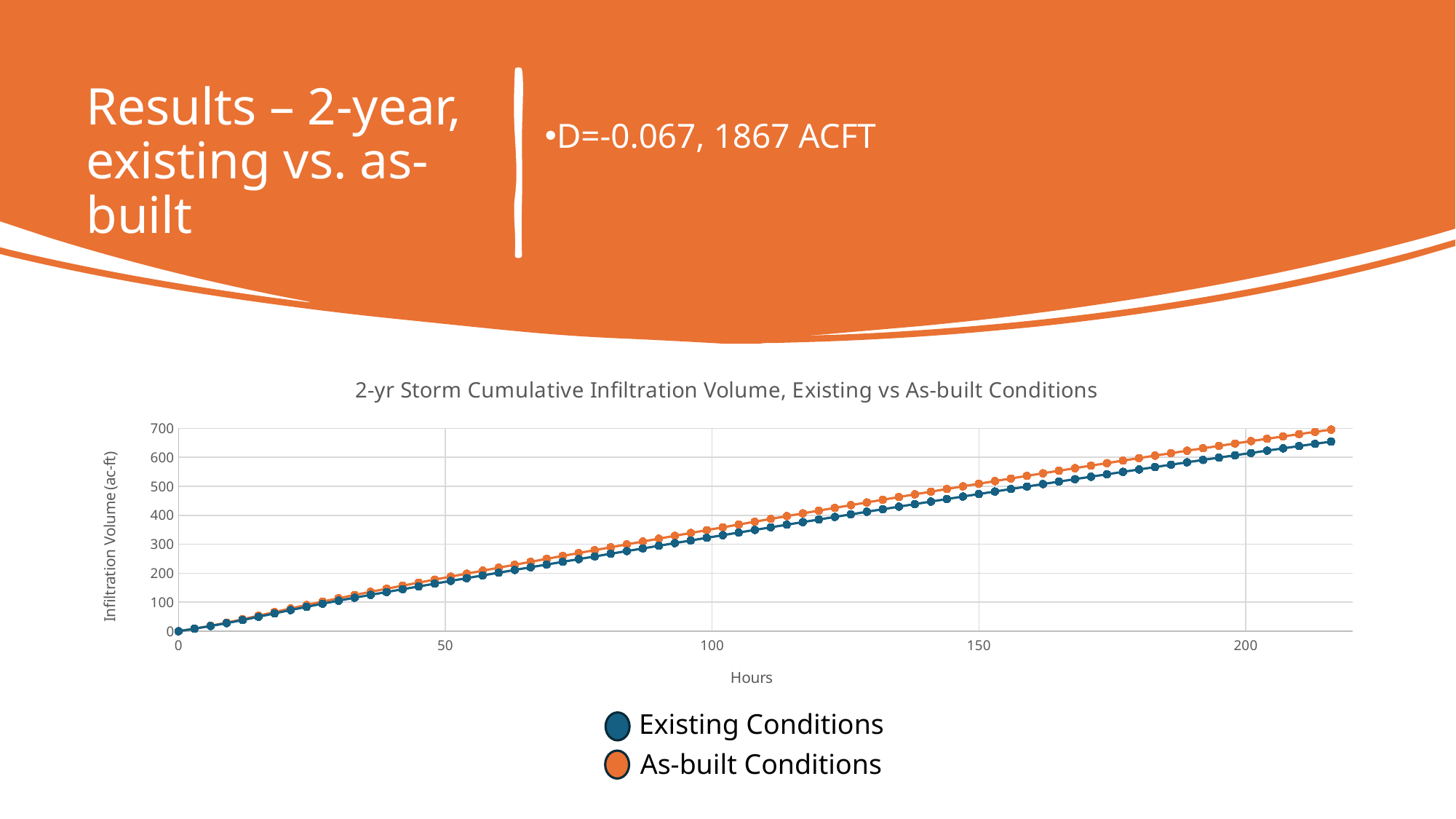
What is the label of the y axis? Infiltration Volume (ac-ft) How many series does the legend list? 2 Do the values for Existing Conditions rise or fall as Hours increase? rise What is the title of the chart? 2-yr Storm Cumulative Infiltration Volume, Existing vs As-built Conditions Which series reaches the highest infiltration volume at the end of the chart? As-built Conditions Is the value for Existing Conditions at 150 hours greater or less than 600? less Is the value for As-built Conditions at 50 hours greater or less than 100? greater At 200 hours, which series has the higher infiltration volume, Existing Conditions or As-built Conditions? As-built Conditions Is the value for Existing Conditions at 100 hours greater or less than 400? less Do the values for As-built Conditions rise or fall as Hours increase? rise What kind of chart is shown on the slide? line chart